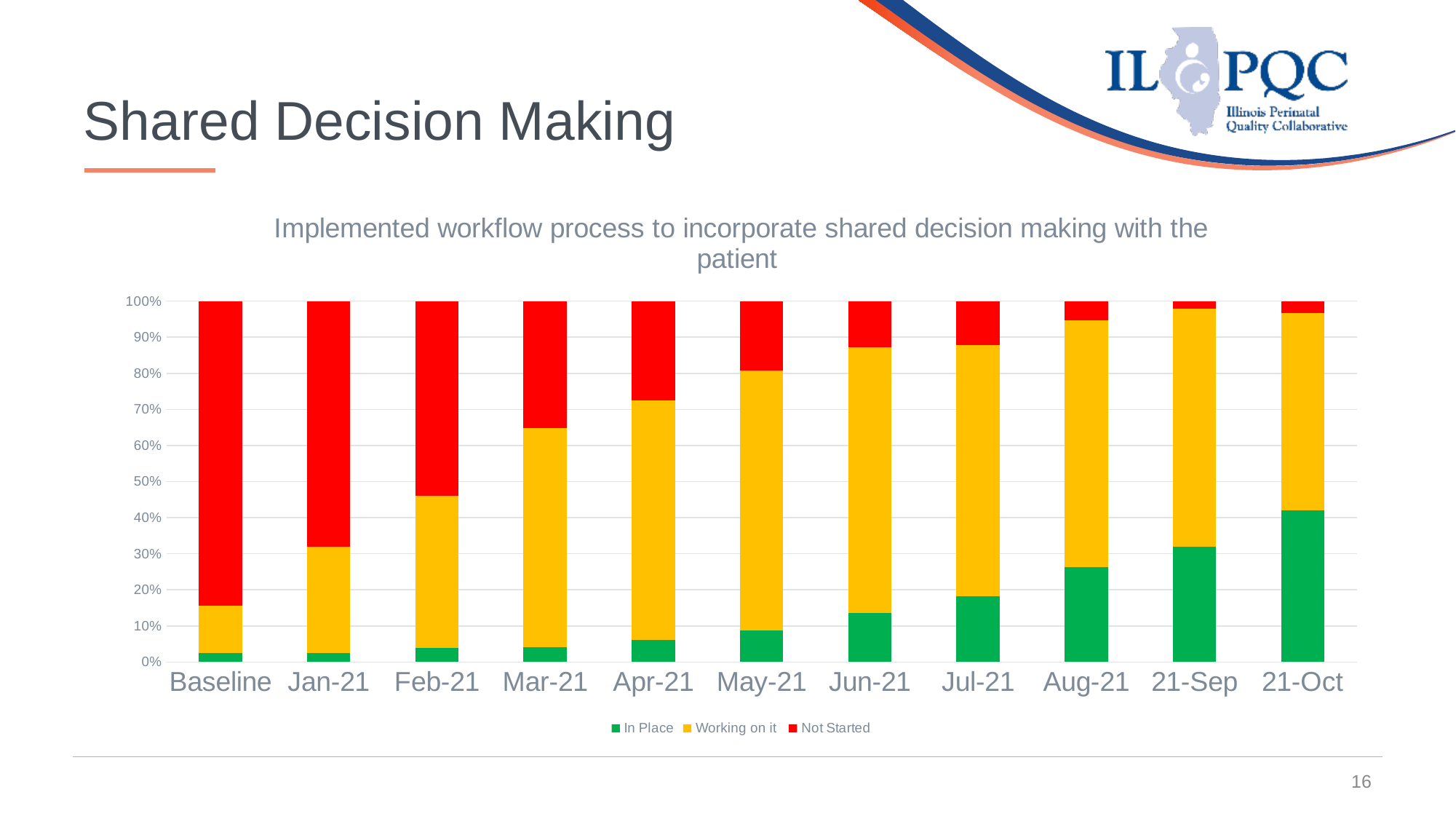
Which is larger, the 'In Place' share for Jul-21 or for Aug-21? Aug-21 Does the 'In Place' share rise or fall from Baseline to 21-Oct? Rise What is the title of the chart? Implemented workflow process to incorporate shared decision making with the patient Is the 'In Place' value for 21-Oct greater or less than 30%? greater What kind of chart is shown on the slide? Bar chart What is the total height of the stacked bar for Baseline? 100% Is the 'Not Started' value for Aug-21 greater or less than 10%? less Which colour represents the 'Not Started' series in the chart? Red Which category has the highest 'In Place' share? 21-Oct How many series does the chart's legend list? 3 Which category has the highest 'Not Started' share? Baseline How many categories are shown along the x axis of the chart? 11